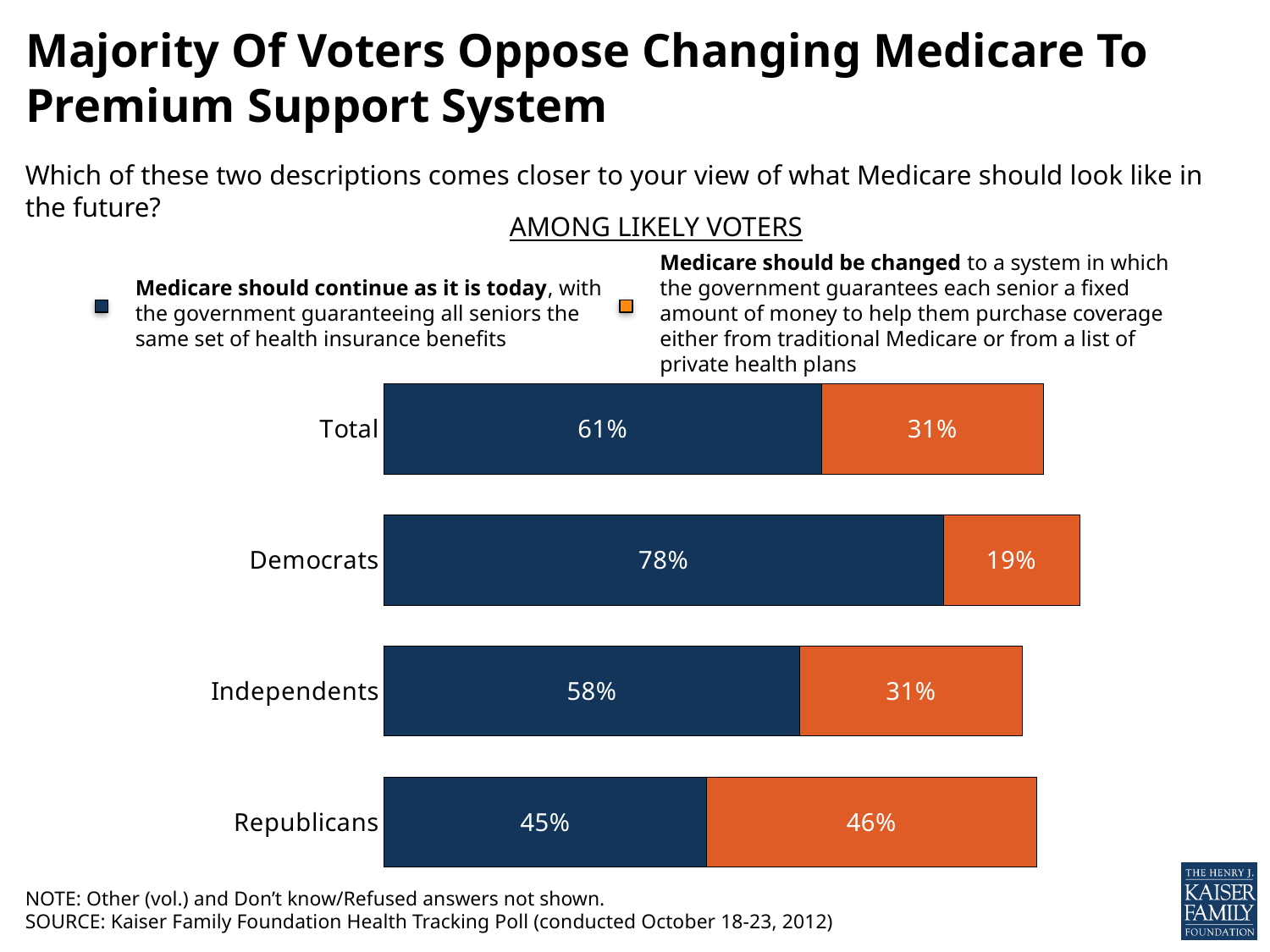
What percentage of Republicans say Medicare should be changed to a premium support system? 46% Among Independents, which is larger: the share saying Medicare should continue as it is today or the share saying it should be changed? Medicare should continue as it is today What percentage of the Total say Medicare should be changed? 31% How many series does the legend list? 2 What percentage of Independents say Medicare should continue as it is today? 58% What is the difference between the share of Democrats and the share of Republicans who say Medicare should continue as it is today? 33 percentage points What percentage of Democrats say Medicare should continue as it is today? 78% Which group has the lowest share saying Medicare should be changed? Democrats What is the combined total of the two responses shown for Democrats? 97% What kind of chart is shown on the slide? Stacked bar chart How many groups are shown in the chart? 4 Which group has the highest share saying Medicare should continue as it is today? Democrats